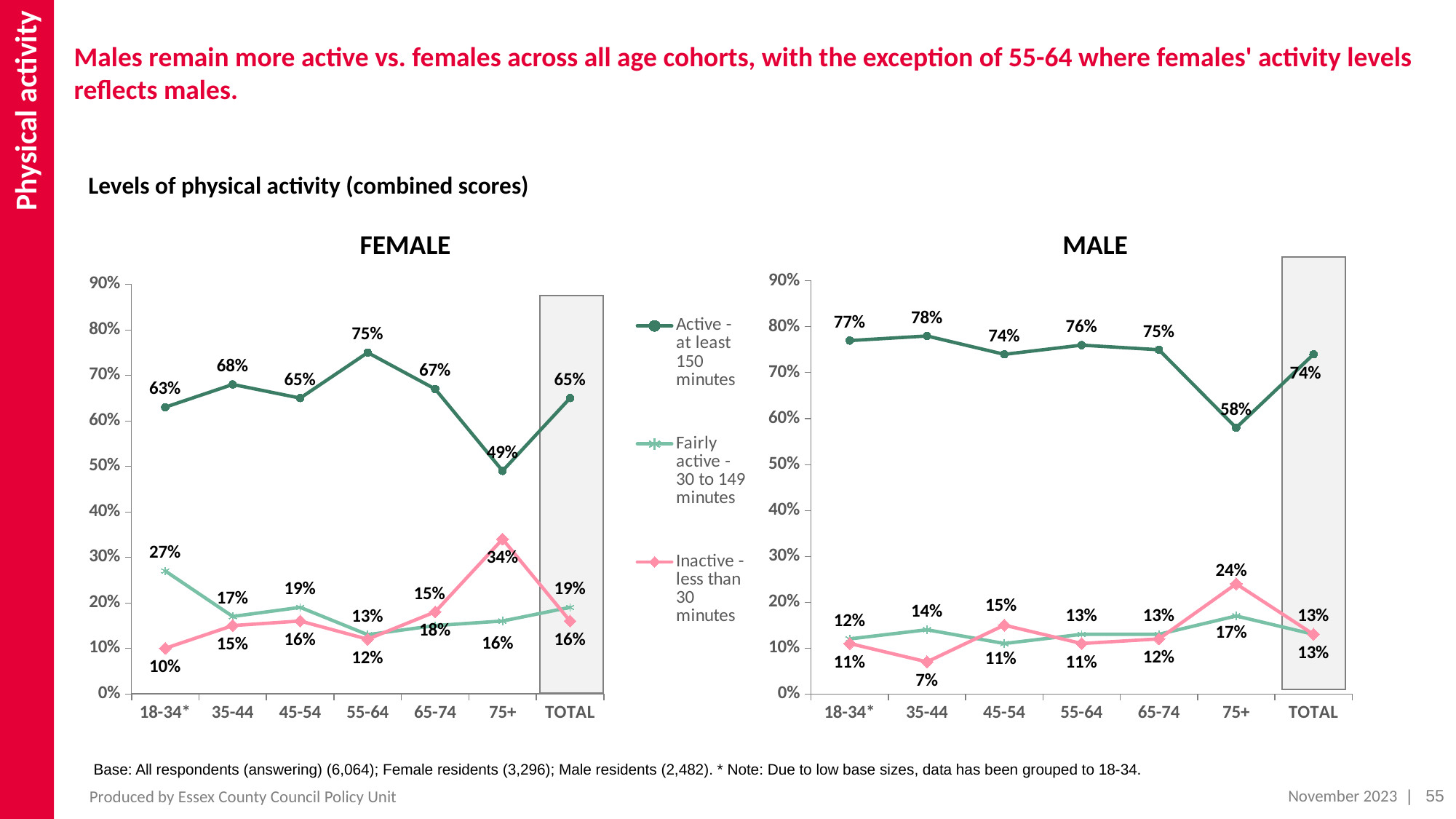
In the MALE chart, which age group has the highest Active value? 35-44 In the FEMALE chart, does the Inactive value rise or fall from 55-64 to 75+? Rise In the FEMALE chart, what is the Inactive value for the 75+ age group? 34% In the FEMALE chart, which age group has the lowest Active value? 75+ In the MALE chart, what is the Inactive value for the 35-44 age group? 7% How many age categories (including TOTAL) are shown on the x axis of the MALE chart? 7 What type of chart is the FEMALE chart? Line chart What is the difference between the TOTAL Active value in the MALE chart and the TOTAL Active value in the FEMALE chart? 9% In the MALE chart, what is the Active value for the 75+ age group? 58% In the FEMALE chart, which is larger for the 18-34* age group: the Fairly active value or the Inactive value? Fairly active In the FEMALE chart, what is the Active value for the 55-64 age group? 75% How many series does the legend list? 3